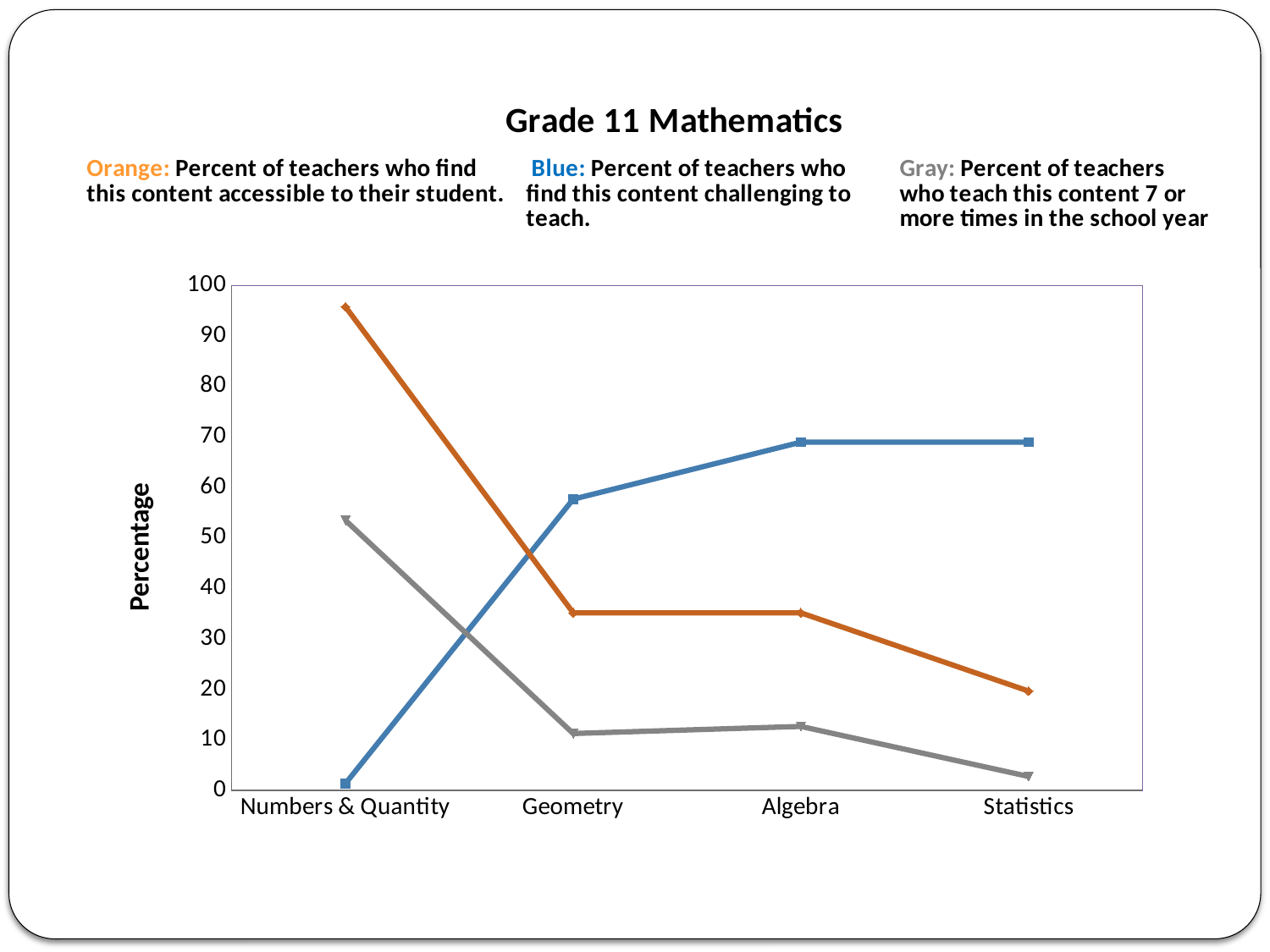
Which is larger at Statistics, the blue value or the orange value? blue What is the title of the chart? Grade 11 Mathematics For which category is the gray line (teachers who teach the content 7 or more times) lowest? Statistics Does the orange line rise or fall from Numbers & Quantity to Statistics? fall Is the orange value for Numbers & Quantity greater or less than 90? greater What kind of chart is shown on the slide? line chart Is the blue value for Geometry greater or less than 50? greater How many lines (series) are plotted on the chart? 3 For which category is the blue line (teachers who find the content challenging to teach) lowest? Numbers & Quantity What is the label on the y axis of the chart? Percentage How many categories are shown on the x axis of the chart? 4 For which category is the orange line (teachers who find the content accessible) highest? Numbers & Quantity